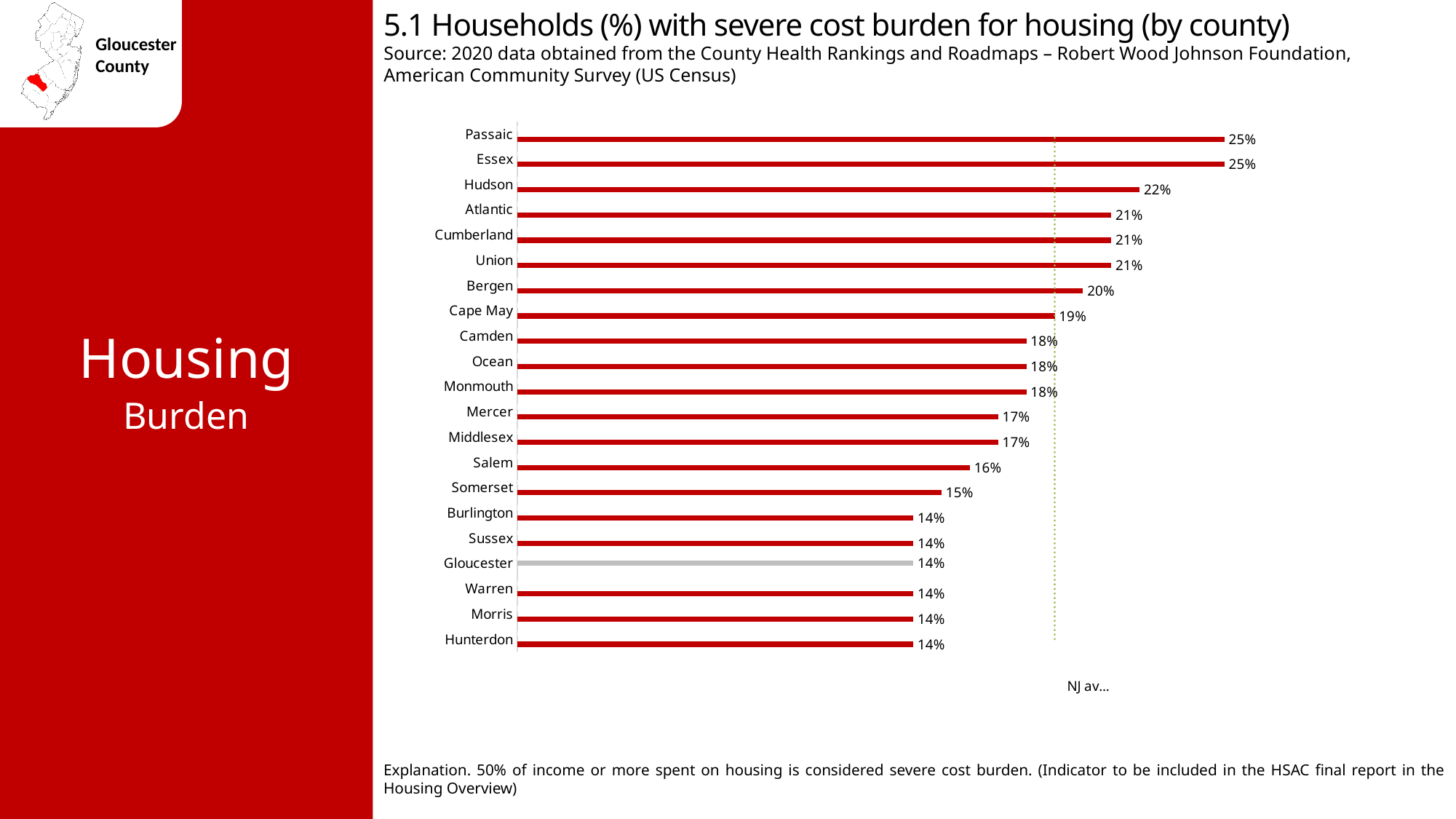
How many counties are shown in the chart? 21 What percentage of households with severe cost burden for housing is shown for Cape May? 19% What kind of chart is shown on the slide? Bar chart Which has a higher value, Cape May or Mercer? Cape May What is the value shown for Hudson County? 22% What is the difference in percentage points between Hudson and Gloucester? 8 What is the value shown for Salem County? 16% Which county's bar is coloured grey instead of red? Gloucester Which has a higher value, Hudson or Bergen? Hudson What is the value shown for Somerset County? 15% What is the value for Gloucester County in the chart? 14% What is the difference in percentage points between Passaic and Bergen? 5